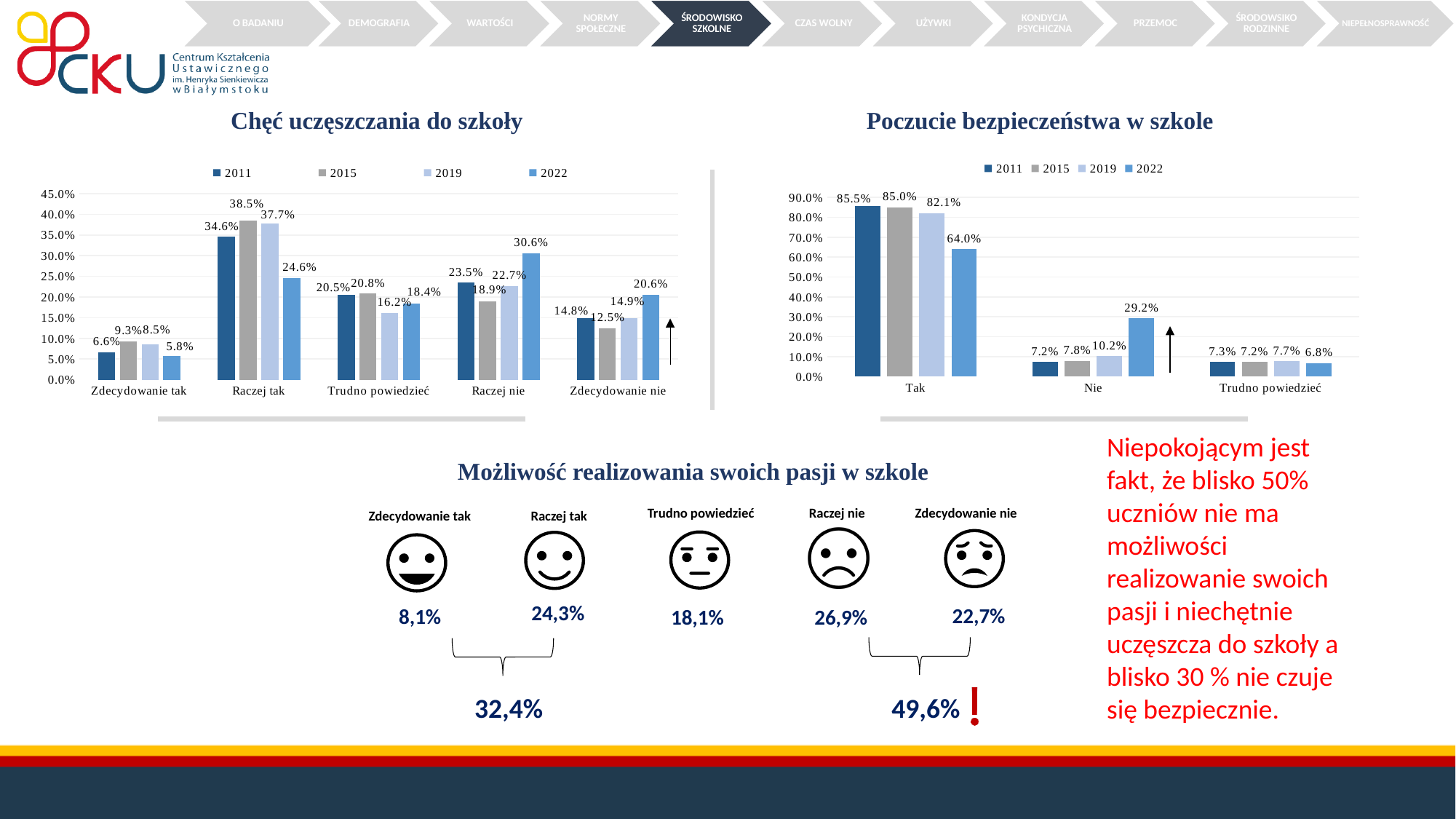
In the chart 'Poczucie bezpieczeństwa w szkole', what is the value for 2022 in the 'Tak' category? 64.0% In the chart 'Poczucie bezpieczeństwa w szkole', which year has the highest value in the 'Nie' category? 2022 In the chart 'Chęć uczęszczania do szkoły', what is the difference between the 2022 and 2011 values for 'Zdecydowanie nie'? 5.8 percentage points In the chart 'Chęć uczęszczania do szkoły', how many series does the legend list? 4 In the chart 'Poczucie bezpieczeństwa w szkole', is the 2019 value for 'Nie' larger or smaller than the 2019 value for 'Trudno powiedzieć'? larger In the chart 'Chęć uczęszczania do szkoły', what is the value for 2015 in the 'Raczej tak' category? 38.5% In the chart 'Chęć uczęszczania do szkoły', how many categories are shown on the x axis? 5 In the chart 'Poczucie bezpieczeństwa w szkole', what is the difference between the 2011 and 2022 values for 'Tak'? 21.5 percentage points In the chart 'Poczucie bezpieczeństwa w szkole', how do the values for 'Tak' change from 2011 to 2022? They fall What type of chart is 'Poczucie bezpieczeństwa w szkole'? Bar chart In the chart 'Chęć uczęszczania do szkoły', which year has the lowest value in the 'Zdecydowanie tak' category? 2022 In the chart 'Chęć uczęszczania do szkoły', what is the value for 2022 in the 'Raczej nie' category? 30.6%